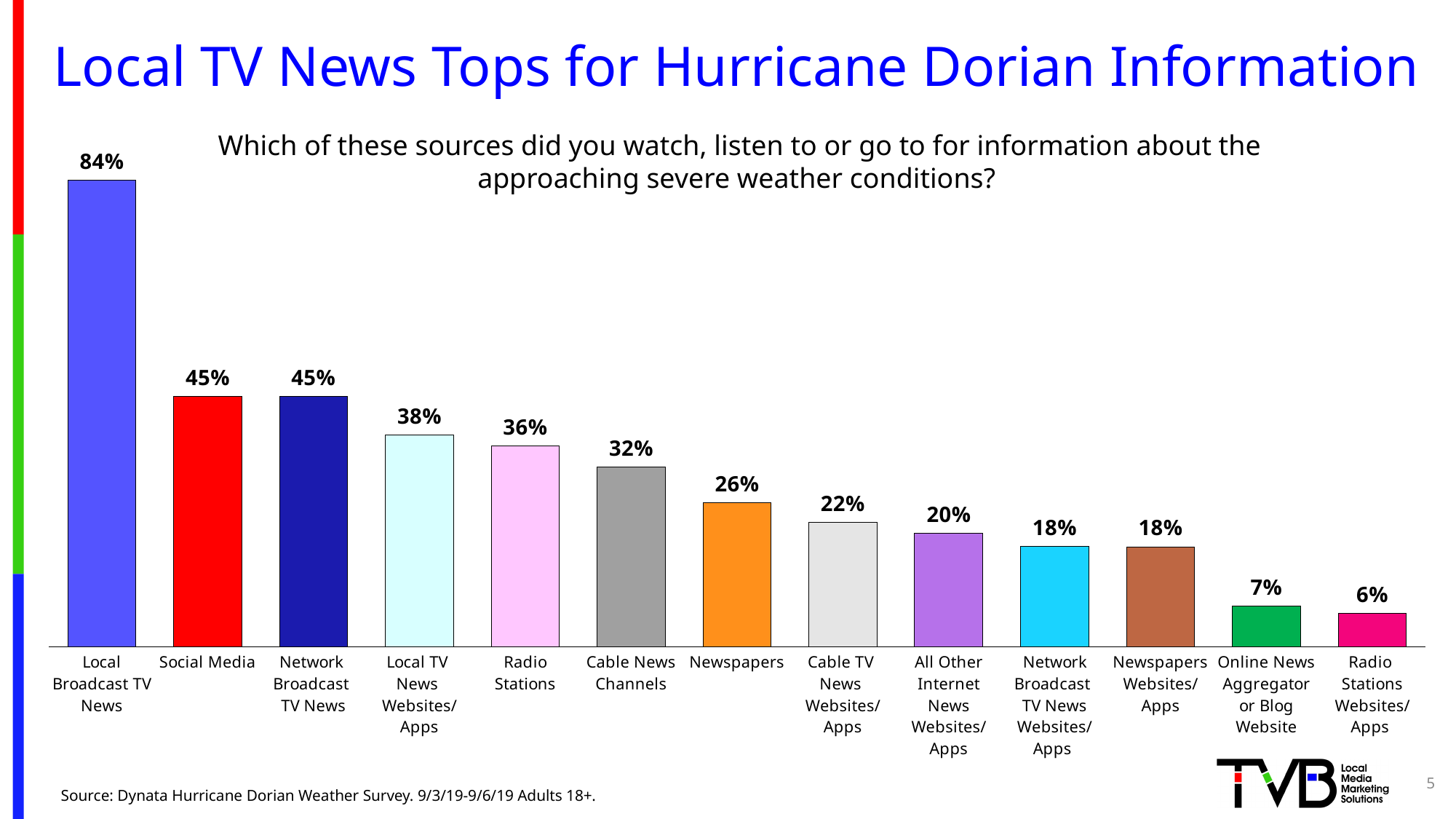
Which source has the highest percentage in the chart? Local Broadcast TV News How many sources (bars) are shown in the chart? 13 What is the difference between the values for Cable News Channels and Newspapers? 6% Which is larger, the value for Local TV News Websites/Apps or the value for Radio Stations? Local TV News Websites/Apps What kind of chart is shown on the slide? Bar chart What is the value shown for Radio Stations? 36% What percentage of respondents used Local Broadcast TV News for information about the approaching severe weather? 84% What colour is the bar for Social Media? Red Do the values generally rise or fall moving from left to right across the chart? Fall What percentage is shown for Cable TV News Websites/Apps? 22% What is the difference between the percentages for Local Broadcast TV News and Social Media? 39% Which source has the lowest percentage in the chart? Radio Stations Websites/Apps